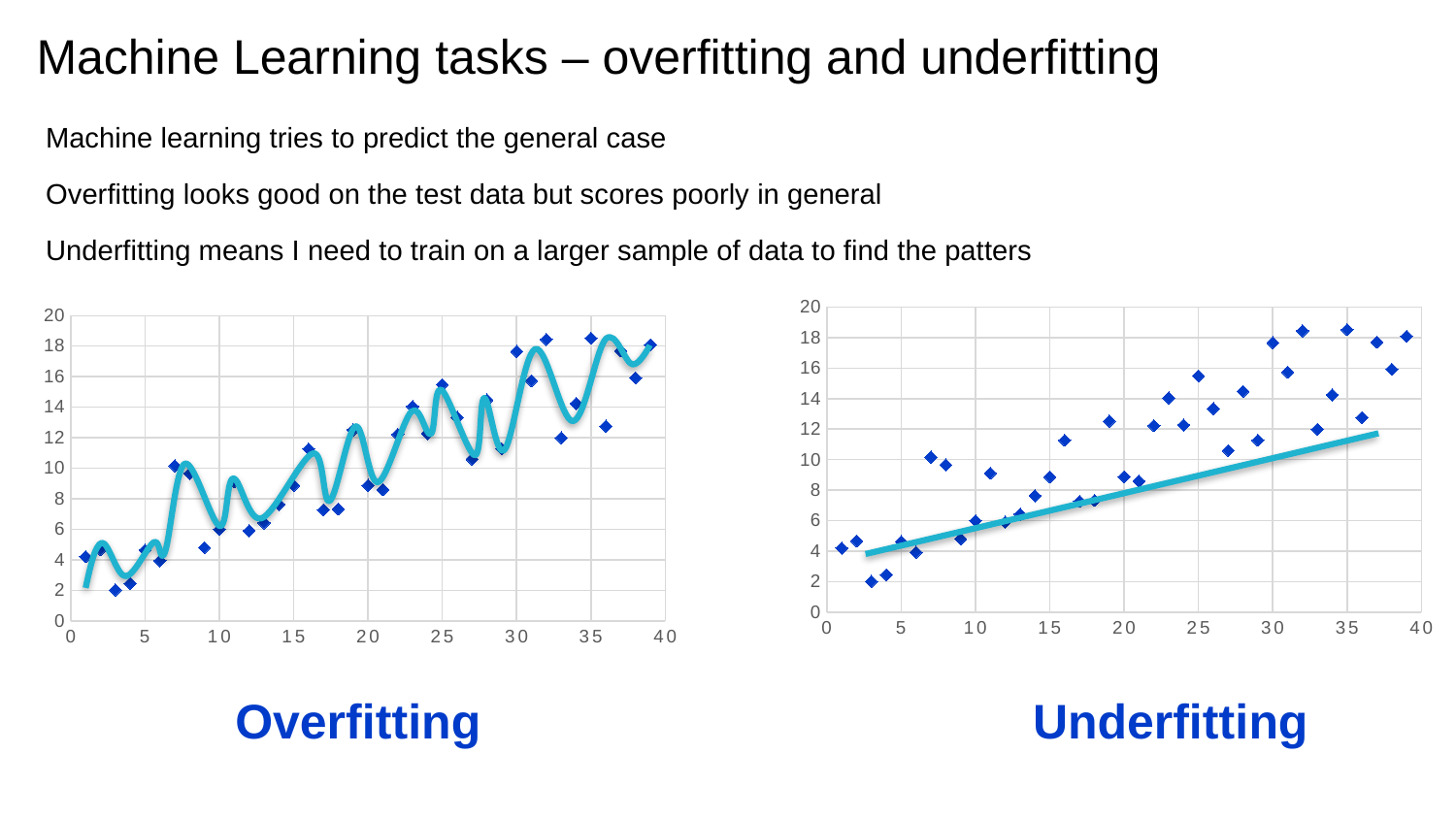
In the Underfitting chart, is the value of the point at x = 7 greater or less than 8? greater Which of the two charts has a straight fitted line rather than a wavy curve? Underfitting In the Overfitting chart, is the value of the point at x = 35 greater or less than 16? greater In the Underfitting chart, which point has the larger value: the one at x = 32 or the one at x = 3? the one at x = 32 What kind of chart is the chart labelled Underfitting? scatter chart What kind of chart is the chart labelled Overfitting? scatter chart In the Underfitting chart, is the value of the point at x = 32 greater or less than 16? greater In the Overfitting chart, do the plotted values generally rise or fall as x increases? rise What is the highest value shown on the y axis of the Overfitting chart? 20 In the Underfitting chart, do the plotted values generally rise or fall as x increases? rise